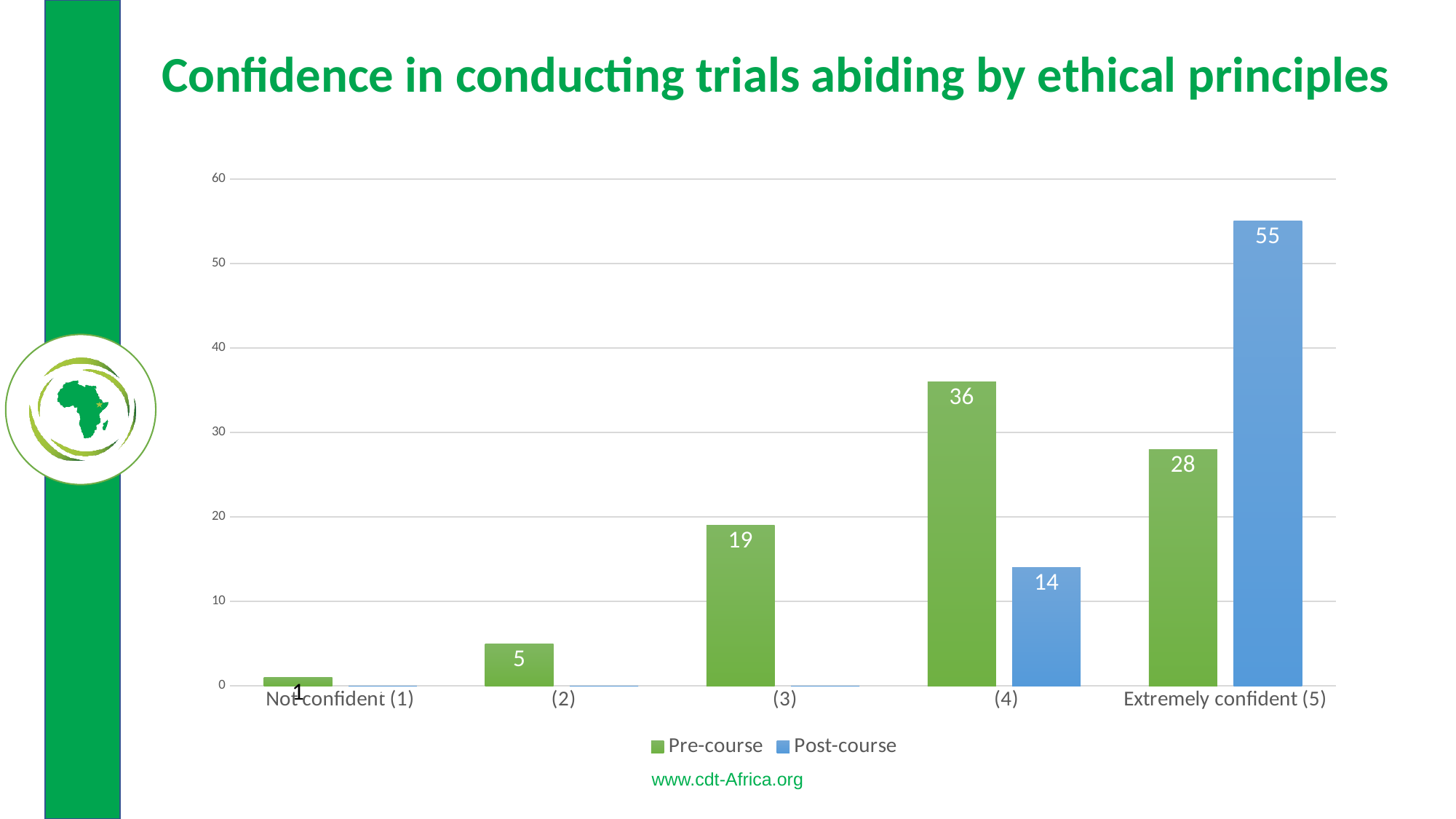
What is the difference between the Post-course and Pre-course values for Extremely confident (5)? 27 Which is larger for the (4) category, the Pre-course value or the Post-course value? Pre-course What is the Pre-course value for the (4) category? 36 Which category has the highest Pre-course value? (4) Is the Post-course value for Extremely confident (5) greater or less than 50? greater What is the Post-course value for Extremely confident (5)? 55 How many categories are shown on the x axis? 5 How many series does the legend list? 2 Which category has the lowest Pre-course value? Not confident (1) What is the Post-course value for the (4) category? 14 What kind of chart is shown on the slide? Bar chart What is the Pre-course value for the (3) category? 19